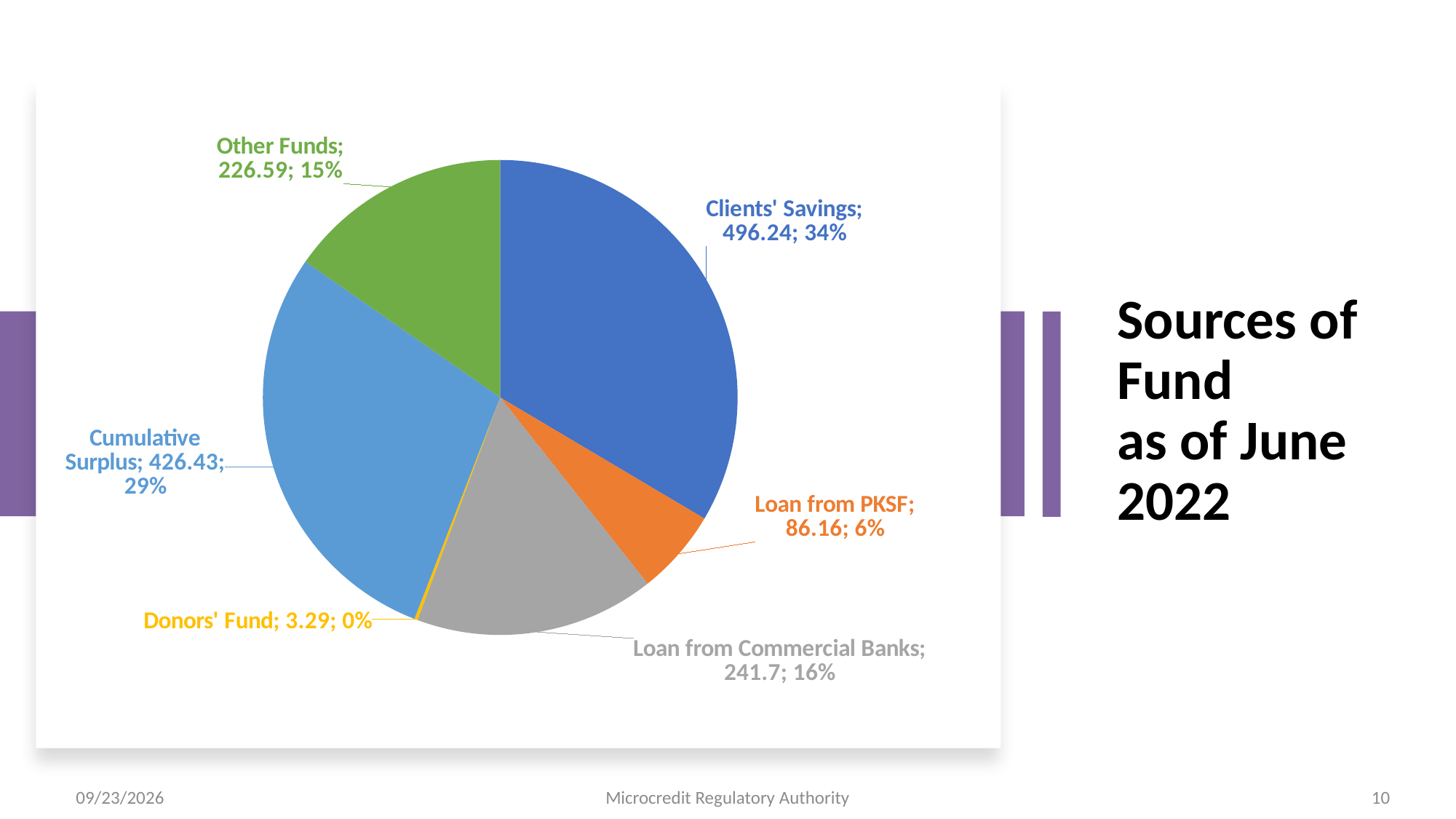
What is the value for Donors' Fund? 3.29 What kind of chart is shown on the slide? pie chart Which source of fund has the smallest slice? Donors' Fund What is the value for Loan from Commercial Banks? 241.7 What is the value for Clients' Savings? 496.24 How many slices does the pie chart have? 6 Which source of fund has the largest slice? Clients' Savings What is the difference between the values for Clients' Savings and Cumulative Surplus? 69.81 What is the title of the slide containing the pie chart? Sources of Fund as of June 2022 What share of the pie does Cumulative Surplus represent? 29% Which is larger, Other Funds or Loan from Commercial Banks? Loan from Commercial Banks What share of the pie does Loan from PKSF represent? 6%